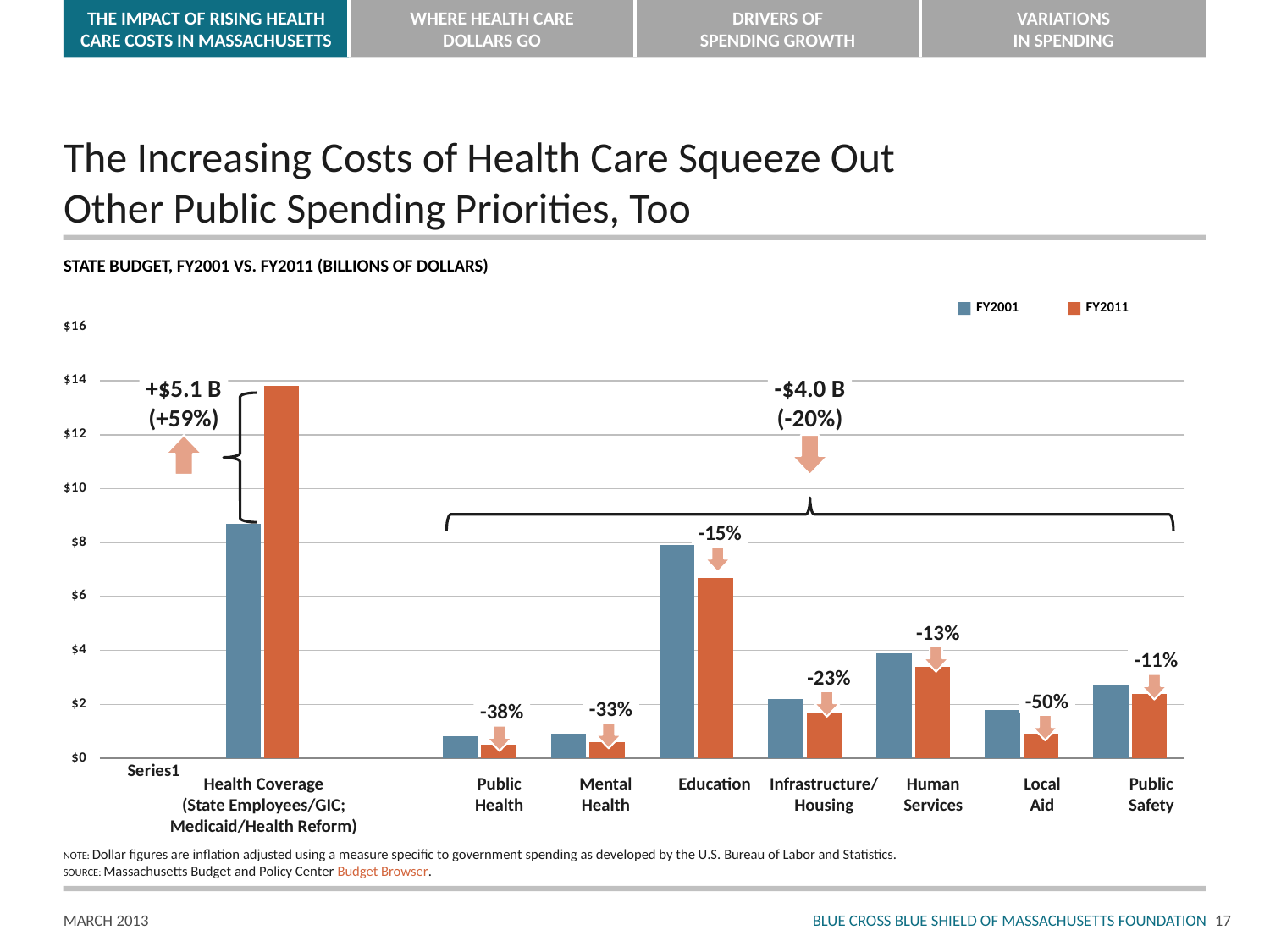
What percentage change is annotated for Local Aid? -50% What kind of chart is shown on the slide? Bar chart What are the two series named in the chart legend? FY2001 and FY2011 For Health Coverage, which is larger: the FY2001 bar or the FY2011 bar? FY2011 How many series does the chart legend list? 2 Is the FY2011 value for Health Coverage greater or less than $12? greater What is the chart's subtitle printed above the plot area? STATE BUDGET, FY2001 VS. FY2011 (BILLIONS OF DOLLARS) Is the FY2011 value for Local Aid greater or less than $2? less Which category has the tallest bar in the chart? Health Coverage For Education, which is larger: the FY2001 bar or the FY2011 bar? FY2001 What dollar change is annotated for Health Coverage? +$5.1 B What percentage change is annotated for Public Health? -38%